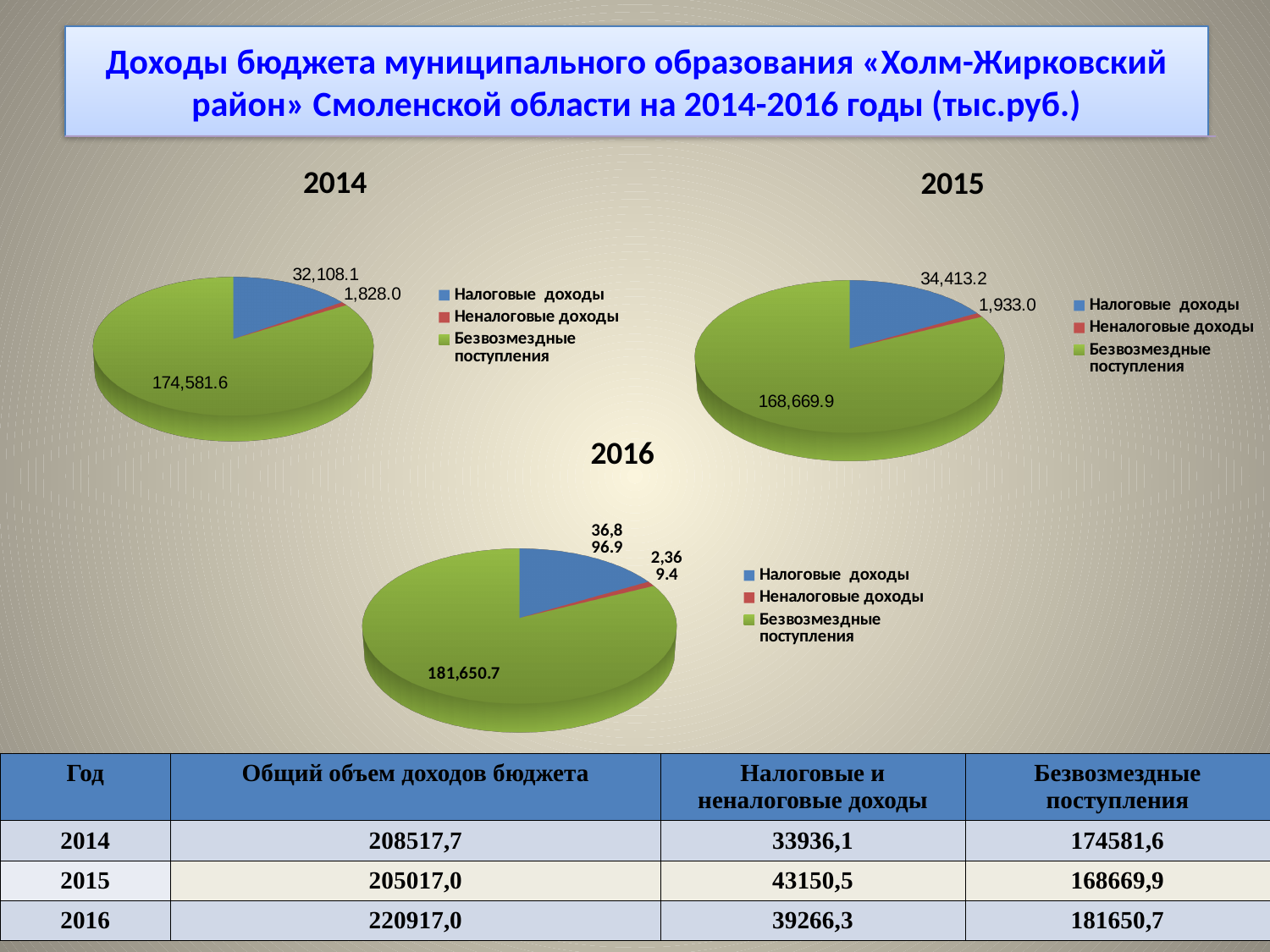
In the 2014 pie chart, what is the value for Налоговые доходы? 32,108.1 In the 2014 pie chart, which category has the smallest slice? Неналоговые доходы In the 2015 pie chart, what is the value for Налоговые доходы? 34,413.2 In the 2016 pie chart, what is the value for Безвозмездные поступления? 181,650.7 What type of chart is used for the 2014 data? Pie chart In the 2014 pie chart, what is the value for Безвозмездные поступления? 174,581.6 In the 2015 pie chart, what is the value for Безвозмездные поступления? 168,669.9 Which is larger: Налоговые доходы in the 2014 chart or Налоговые доходы in the 2015 chart? 2015 In the 2015 pie chart, which category has the largest slice? Безвозмездные поступления In the 2014 pie chart, what is the value for Неналоговые доходы? 1,828.0 In the 2015 pie chart, what is the difference between Налоговые доходы and Неналоговые доходы? 32,480.2 How many slices does the 2016 pie chart have? 3